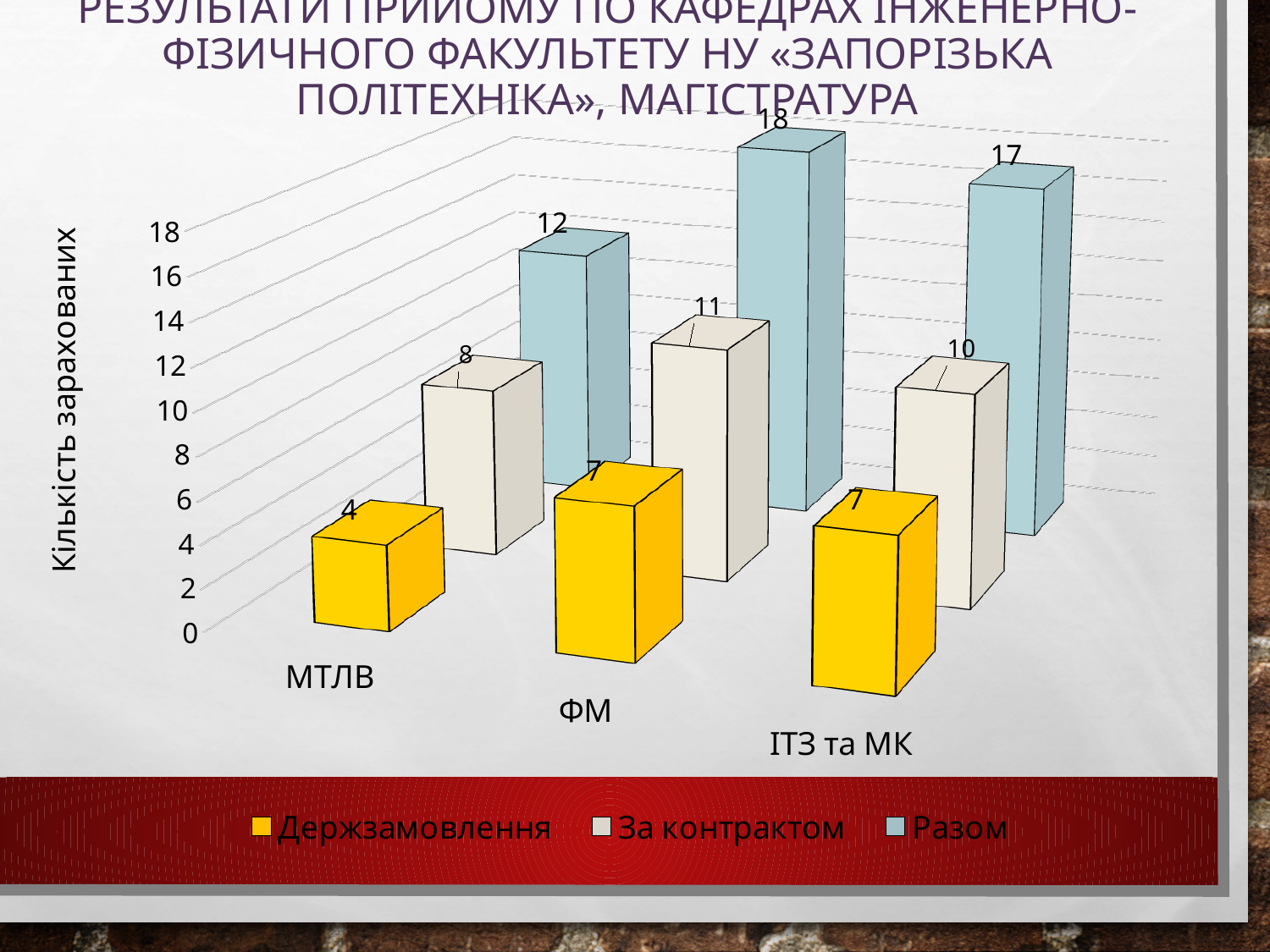
What is the value of За контрактом for ФМ? 11 What is the value of Разом for ІТЗ та МК? 17 What is the difference between the Разом values for ФМ and МТЛВ? 6 What is the label of the vertical axis? Кількість зарахованих Which category has the highest Разом value? ФМ Which category has the lowest Держзамовлення value? МТЛВ Which is larger: За контрактом for ФМ or За контрактом for ІТЗ та МК? За контрактом for ФМ How many categories are shown on the x axis? 3 What is the value of Держзамовлення for МТЛВ? 4 What kind of chart is shown on the slide? Bar chart What is the value of За контрактом for ІТЗ та МК? 10 How many series does the legend list? 3